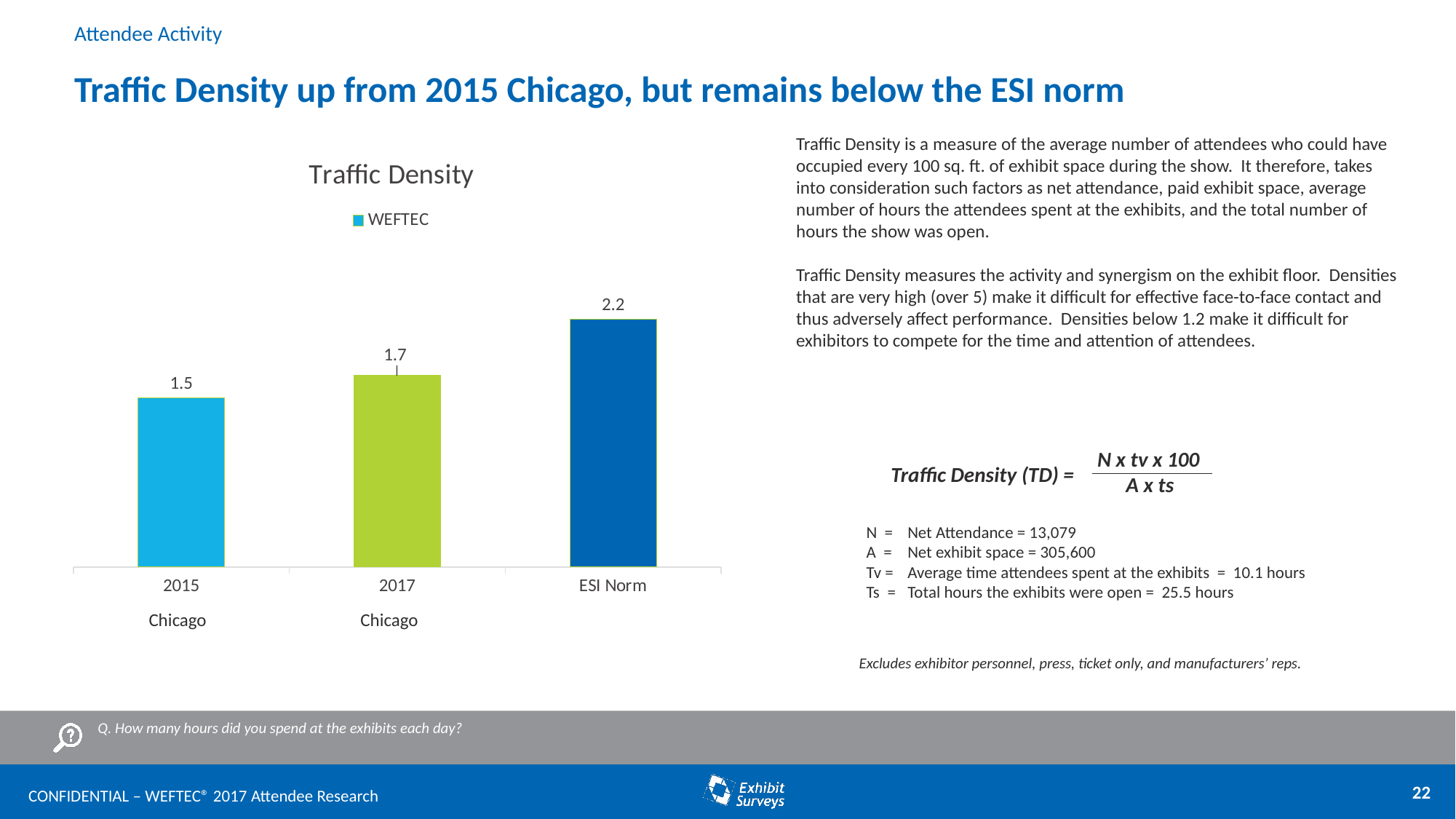
What is the difference in Traffic Density between the ESI Norm and 2017 Chicago? 0.5 Which category has the lowest Traffic Density? 2015 Chicago What series name is shown in the legend of the Traffic Density chart? WEFTEC Which is larger, the Traffic Density for 2017 Chicago or for 2015 Chicago? 2017 Chicago Which category has the highest Traffic Density? ESI Norm What is the Traffic Density value for 2015 Chicago? 1.5 What kind of chart is the Traffic Density chart? Bar chart How many series does the legend of the Traffic Density chart list? 1 What is the Traffic Density value for the ESI Norm? 2.2 How many categories are shown in the Traffic Density chart? 3 What is the Traffic Density value for 2017 Chicago? 1.7 What is the difference in Traffic Density between 2017 Chicago and 2015 Chicago? 0.2